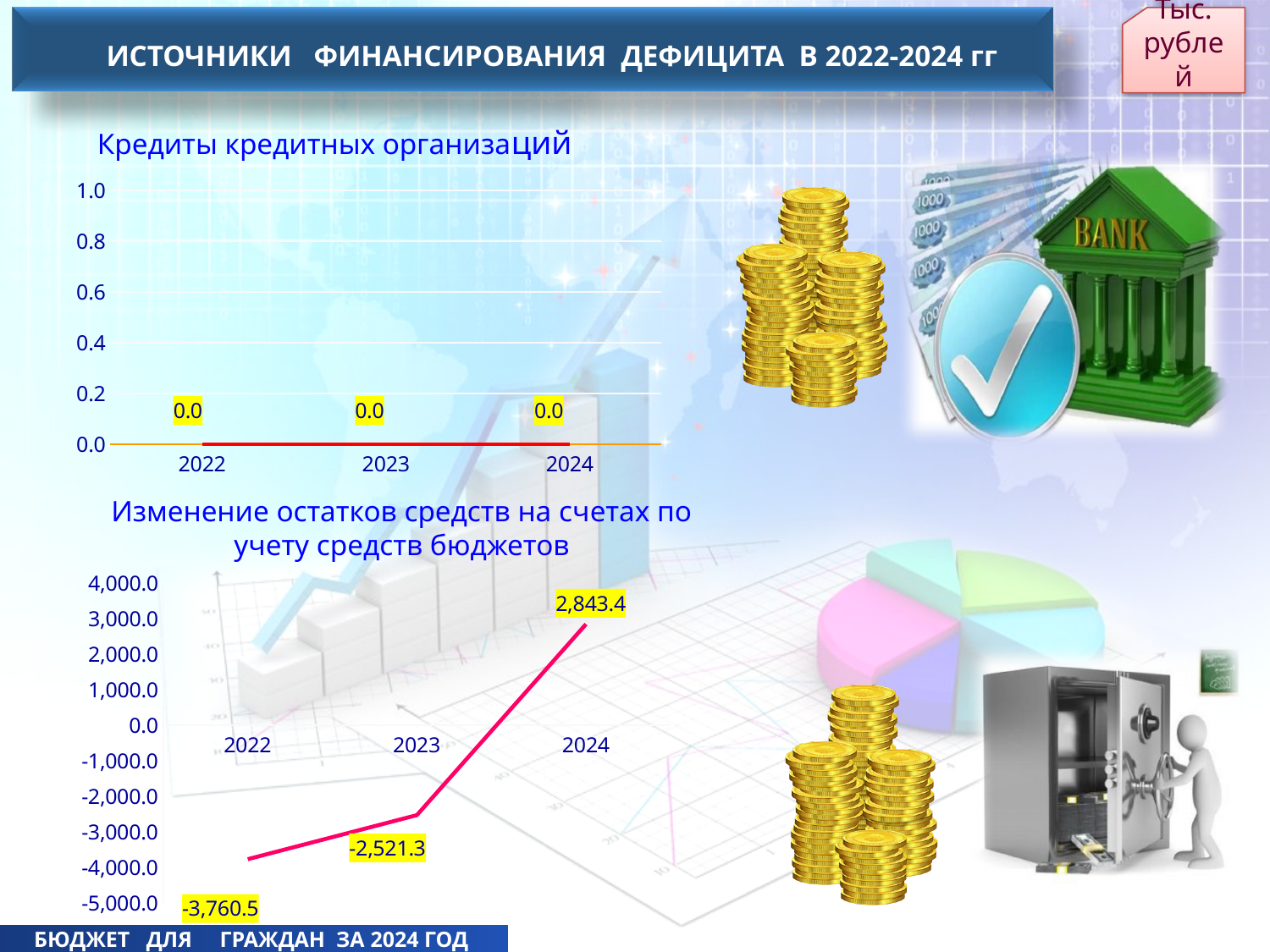
In the chart 'Изменение остатков средств на счетах по учету средств бюджетов', is the value for 2023 larger than the value for 2022? Yes In the chart 'Изменение остатков средств на счетах по учету средств бюджетов', what is the value for 2023? -2,521.3 What kind of chart is 'Кредиты кредитных организаций'? line chart In the chart 'Изменение остатков средств на счетах по учету средств бюджетов', what is the value for 2022? -3,760.5 In the chart 'Кредиты кредитных организаций', how many years are plotted? 3 In the chart 'Изменение остатков средств на счетах по учету средств бюджетов', which year has the highest value? 2024 In the chart 'Изменение остатков средств на счетах по учету средств бюджетов', do the values rise or fall from 2022 to 2024? rise In the chart 'Изменение остатков средств на счетах по учету средств бюджетов', what is the value for 2024? 2,843.4 In the chart 'Изменение остатков средств на счетах по учету средств бюджетов', what is the difference between the 2024 value and the 2023 value? 5,364.7 What kind of chart is 'Изменение остатков средств на счетах по учету средств бюджетов'? line chart In the chart 'Изменение остатков средств на счетах по учету средств бюджетов', which year has the lowest value? 2022 In the chart 'Кредиты кредитных организаций', what is the value for 2023? 0.0